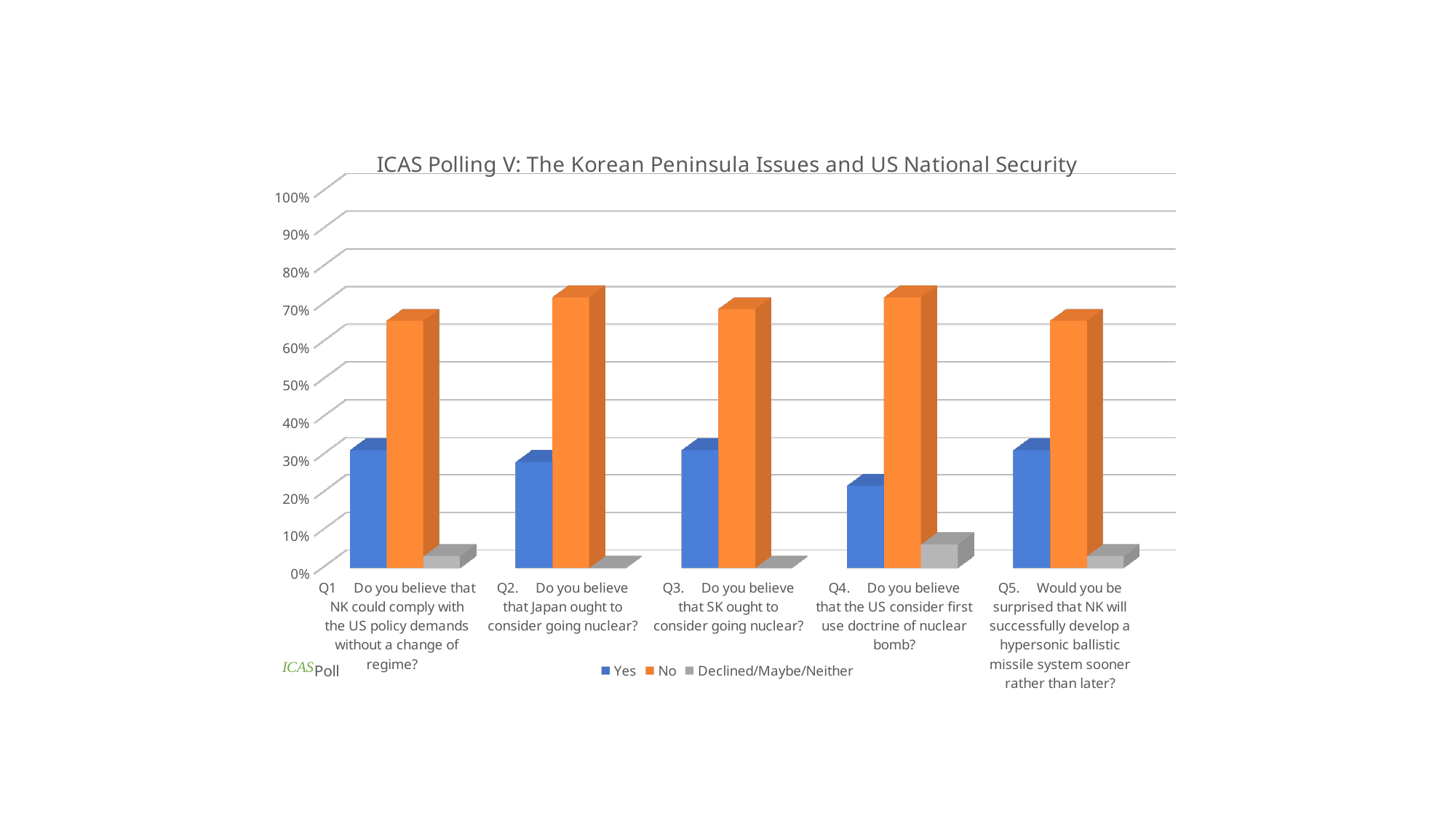
Which question has the highest Declined/Maybe/Neither value? Q4 Is the No value for Q2 greater or less than 60%? greater Is the Yes value for Q4 greater or less than 30%? less What is the title of the chart? ICAS Polling V: The Korean Peninsula Issues and US National Security Is the Yes value for Q1 greater or less than 40%? less How many series does the legend list? 3 What are the three series named in the legend? Yes, No, Declined/Maybe/Neither Which question has the lowest Yes value? Q4 What kind of chart is shown on the slide? bar chart Which response series has the tallest bar for every question? No Which is larger for Q1, the Yes value or the No value? No How many poll questions (categories) are shown on the x axis? 5